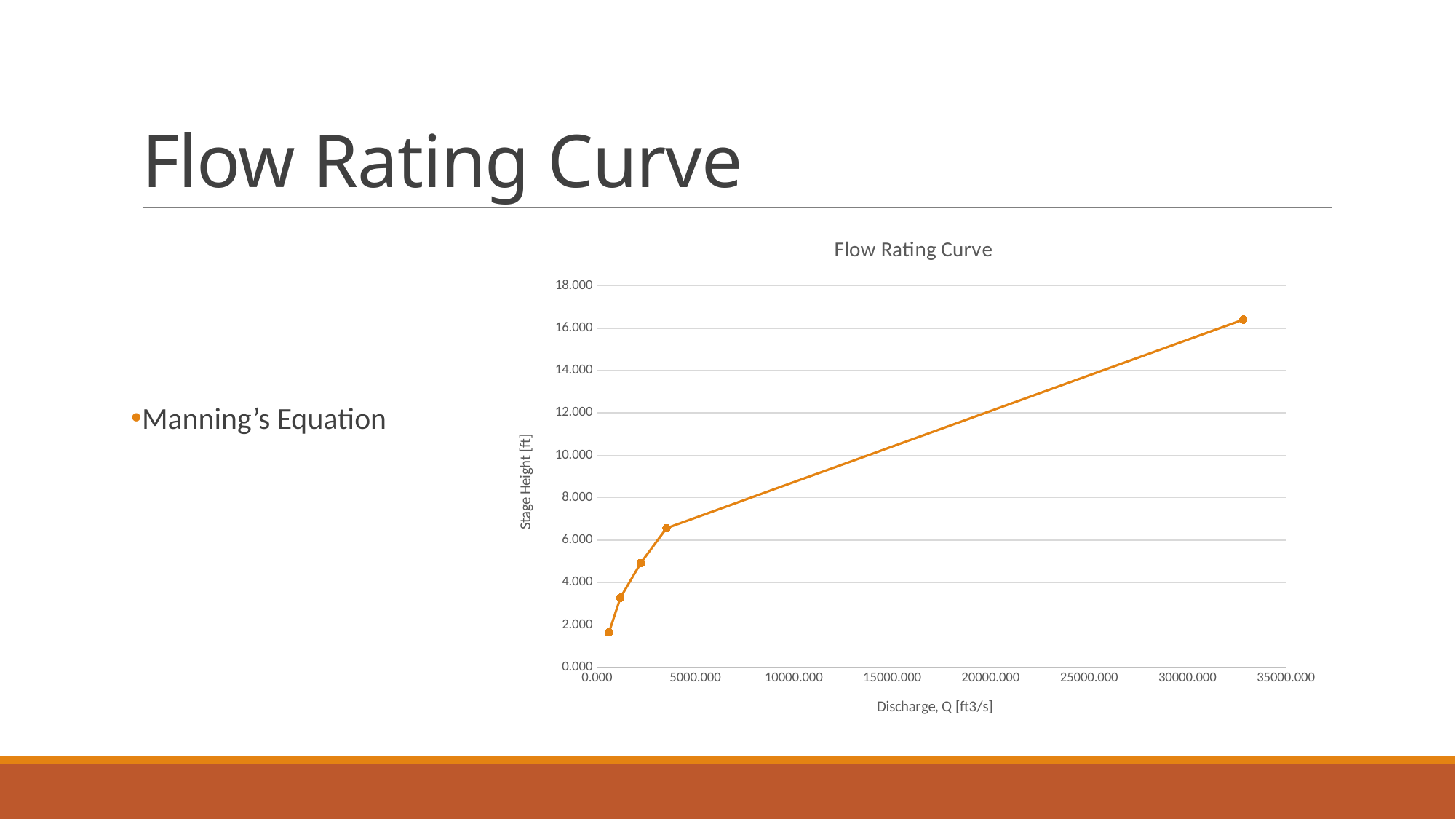
Does the stage height rise or fall as discharge increases along the x axis? rise What is the label of the x axis of the chart? Discharge, Q [ft3/s] What is the title of the chart? Flow Rating Curve Are the discharges of the four leftmost data points greater or less than 5000.000 ft3/s? less Is the stage height of the rightmost data point greater or less than 16.000 ft? greater How many data points are plotted on the chart? 5 Is the discharge of the highest data point greater or less than 30000.000 ft3/s? greater What kind of chart is shown on the slide? line chart